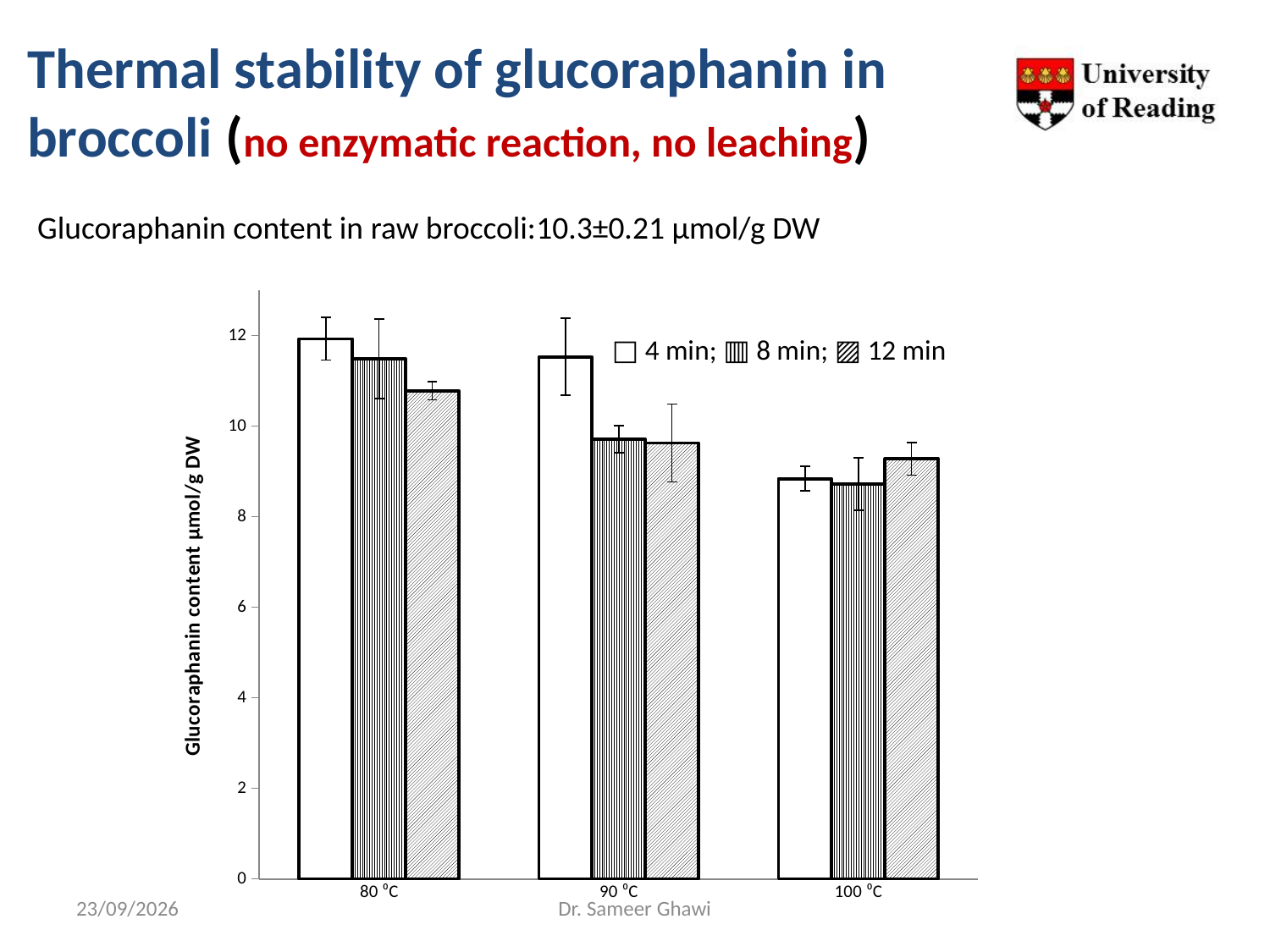
How many series does the legend list? 3 What is the label of the y axis? Glucoraphanin content µmol/g DW Which series are listed in the legend? 4 min; 8 min; 12 min For the 4 min series, at which temperature is the glucoraphanin content highest? 80 °C Is the value for 4 min at 100 °C greater or less than 10? less How many temperature categories are shown on the x axis? 3 At 80 °C, which is larger: the 4 min value or the 12 min value? 4 min Is the value for 8 min at 90 °C greater or less than 10? less At 90 °C, which is larger: the 4 min value or the 8 min value? 4 min Do the 4 min values rise or fall as temperature increases from 80 °C to 100 °C? fall Is the value for 12 min at 80 °C greater or less than 10? greater What kind of chart is shown on the slide? bar chart